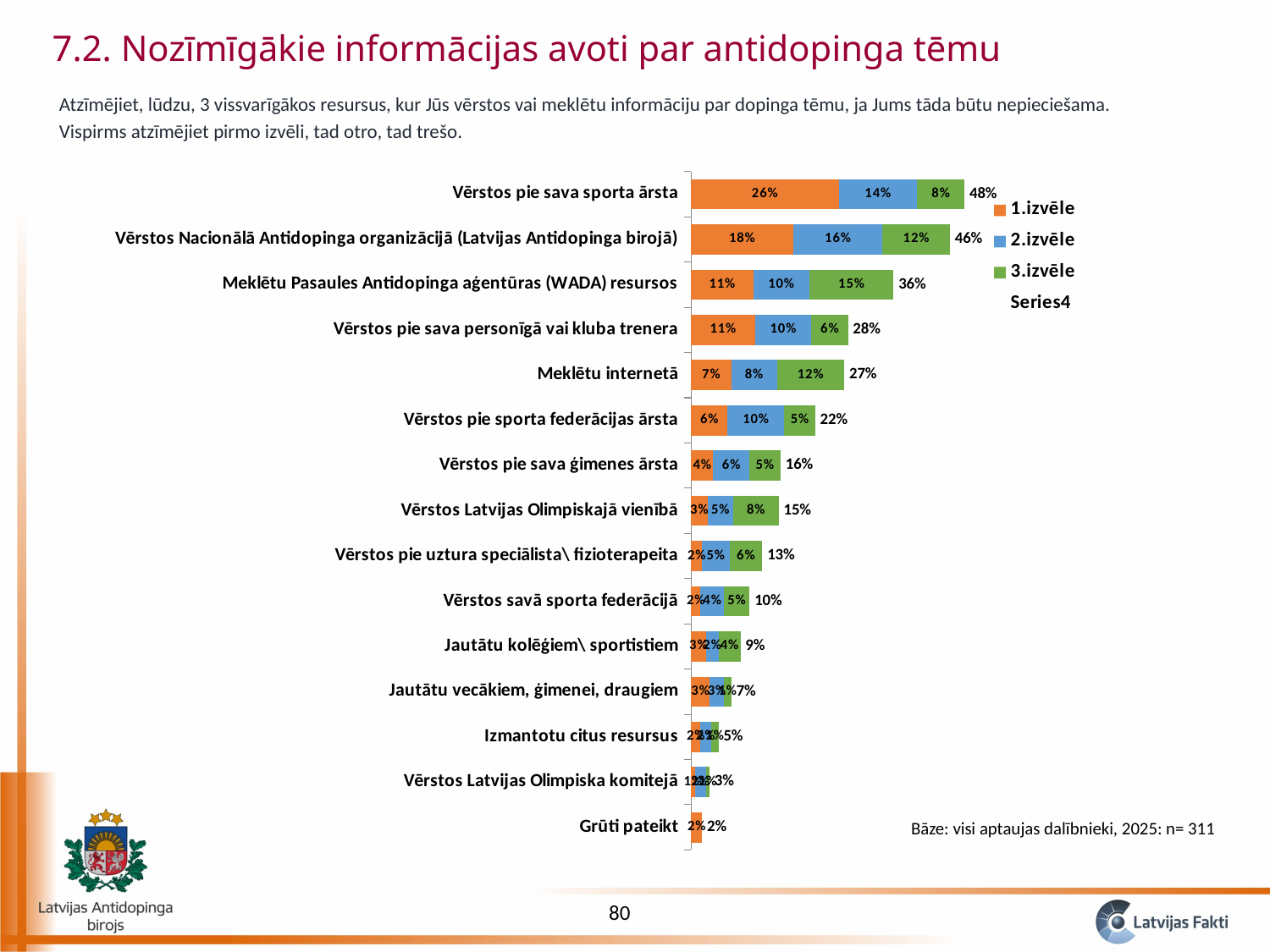
Which category has the highest total? Vērstos pie sava sporta ārsta What is the 2.izvēle value for "Vērstos Nacionālā Antidopinga organizācijā (Latvijas Antidopinga birojā)"? 16% What is the total shown at the end of the bar for "Meklētu internetā"? 27% What colour represents 3.izvēle in the chart? Green How many entries does the chart legend list? 4 How many categories are shown on the chart? 15 Which has a larger 1.izvēle value: "Meklētu internetā" or "Vērstos pie sporta federācijas ārsta"? Meklētu internetā What is the 1.izvēle value for "Vērstos pie sava sporta ārsta"? 26% What is the 3.izvēle value for "Meklētu Pasaules Antidopinga aģentūras (WADA) resursos"? 15% What is the difference between the totals for "Vērstos pie sava sporta ārsta" and "Vērstos Nacionālā Antidopinga organizācijā (Latvijas Antidopinga birojā)"? 2% What kind of chart is shown on the slide? Stacked bar chart Which category has the lowest total? Grūti pateikt